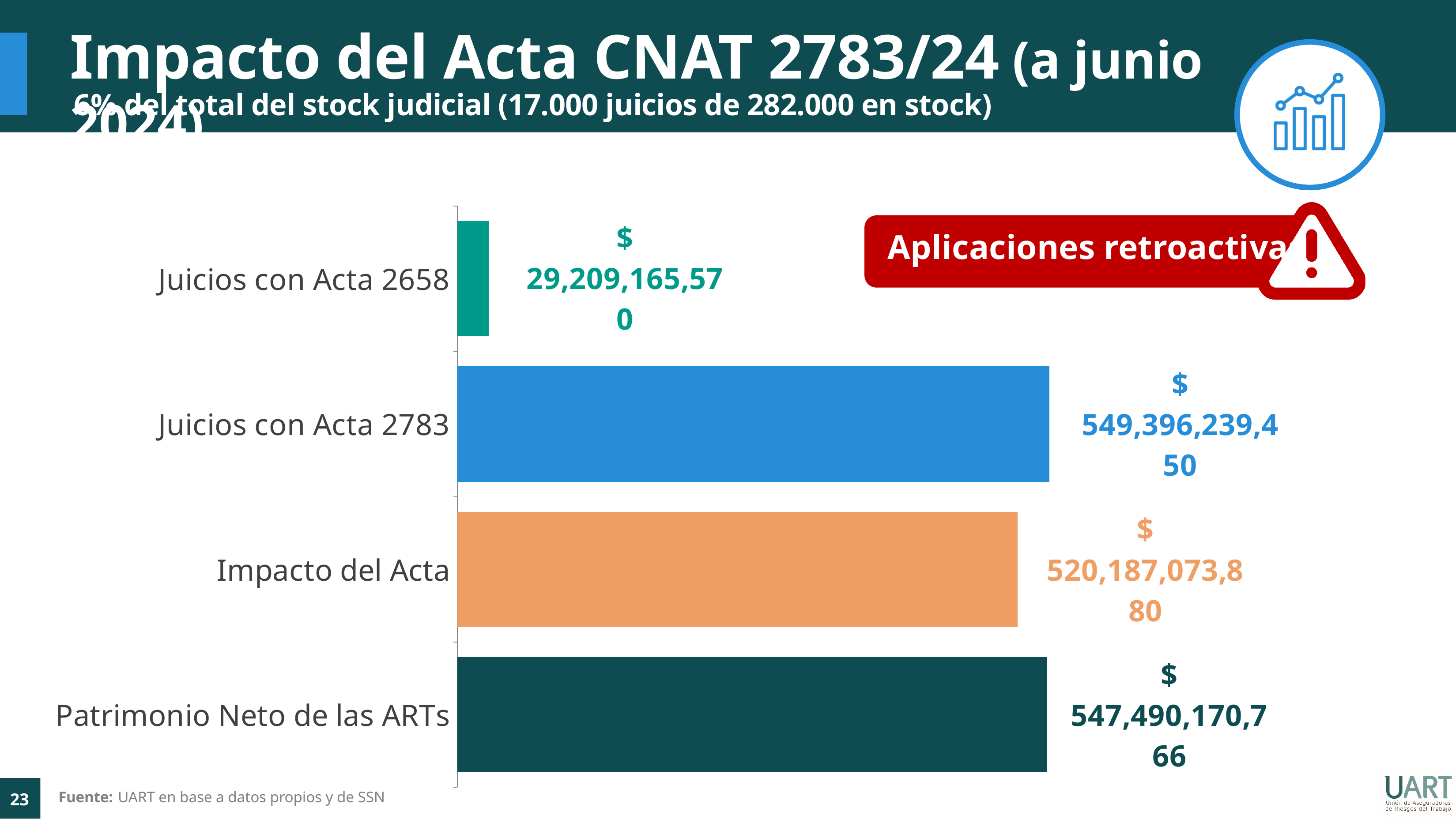
What is the value shown for Impacto del Acta? $ 520,187,073,880 What text appears in the red callout box on the chart? Aplicaciones retroactivas What kind of chart is shown on the slide? Bar chart Which is larger, the value for Impacto del Acta or the value for Juicios con Acta 2658? Impacto del Acta What is the value shown for Juicios con Acta 2658? $ 29,209,165,570 What is the value shown for Patrimonio Neto de las ARTs? $ 547,490,170,766 Which category has the highest value in the chart? Juicios con Acta 2783 What is the difference between the values for Juicios con Acta 2783 and Patrimonio Neto de las ARTs? $ 1,906,068,684 Which category has the lowest value in the chart? Juicios con Acta 2658 What is the value shown for Juicios con Acta 2783? $ 549,396,239,450 What is the difference between the values for Juicios con Acta 2783 and Impacto del Acta? $ 29,209,165,570 How many categories are shown in the chart? 4